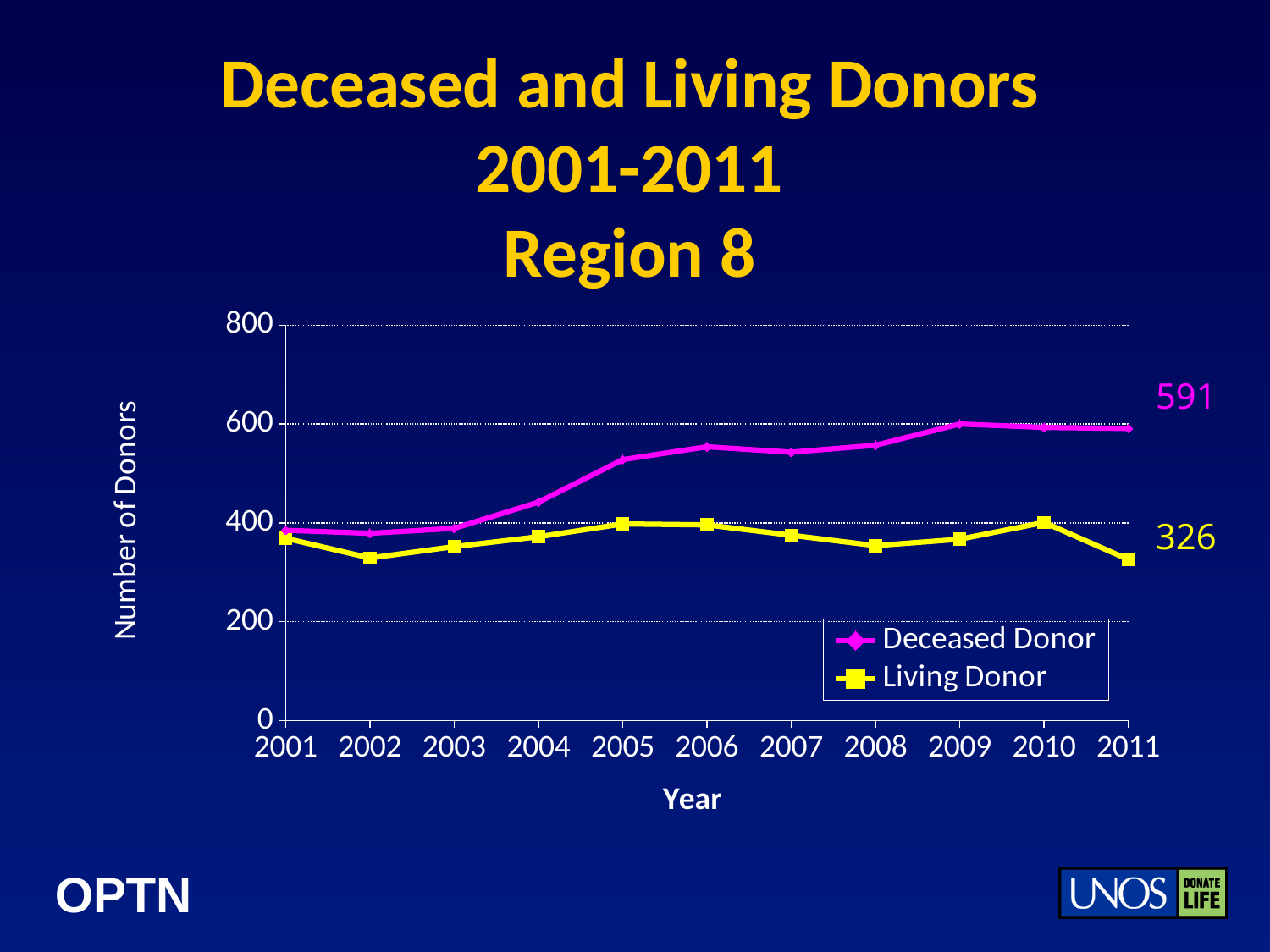
Is the value for Deceased Donor in 2009 greater or less than 400? greater Which series has the larger value in 2011, Deceased Donor or Living Donor? Deceased Donor What is the value for Deceased Donor in 2011? 591 What is the value for Living Donor in 2011? 326 What kind of chart is shown on the slide? line chart How many series does the legend list? 2 Is the value for Deceased Donor in 2005 greater or less than 400? greater Is the value for Living Donor in 2002 greater or less than 400? less Does the Deceased Donor series generally rise or fall from 2001 to 2011? rise What is the label of the y axis? Number of Donors What is the difference between the Deceased Donor and Living Donor values in 2011? 265 How many years are shown on the x axis? 11